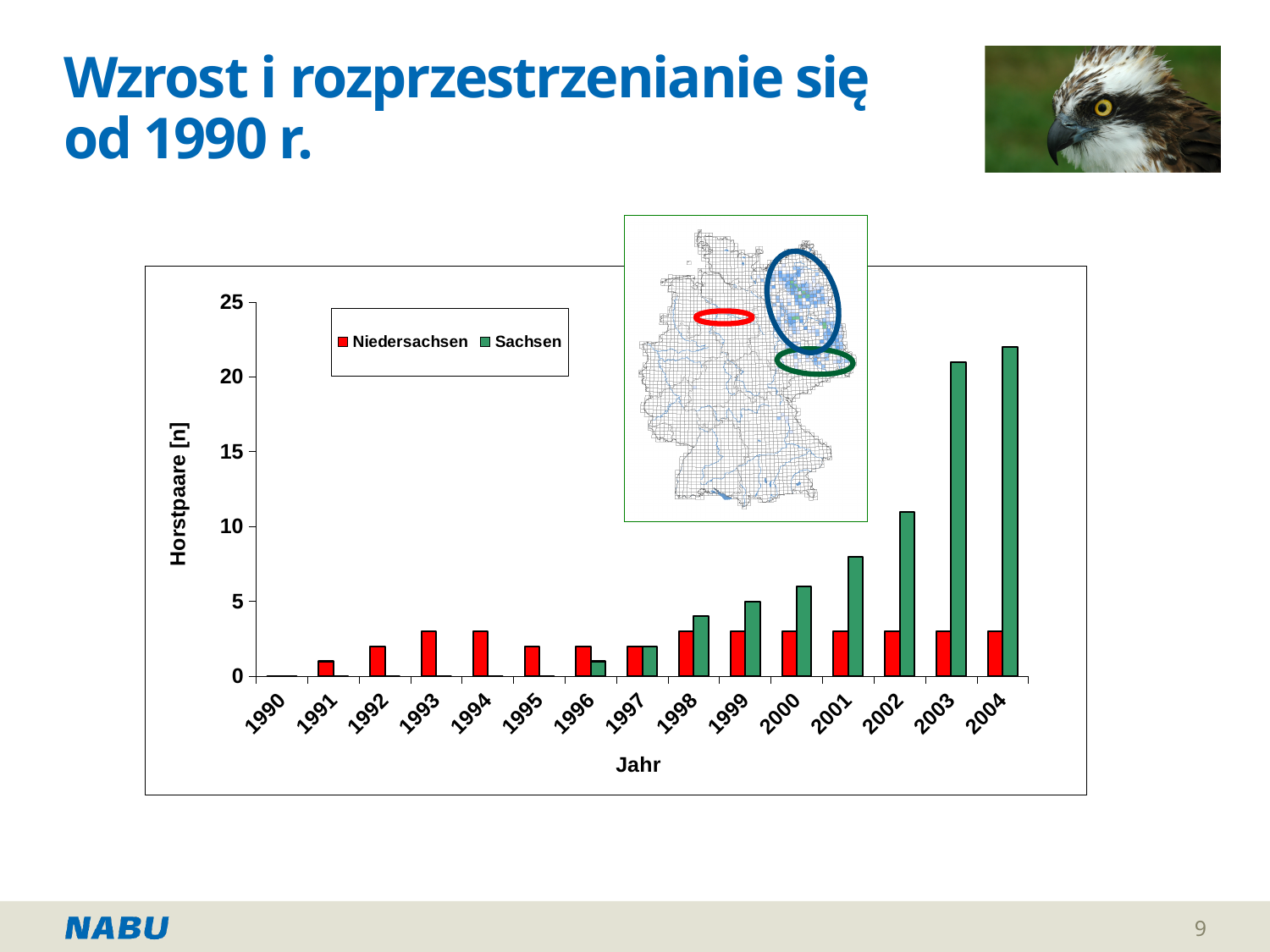
Is the Sachsen value for 2002 greater or less than 10? greater Is the Sachsen value for 2001 greater or less than 10? less Do the Sachsen values rise or fall from 1996 to 2004? rise Is the Niedersachsen value for 2004 greater or less than 5? less What kind of chart is shown on the slide? bar chart In 1993, which series has the larger value, Niedersachsen or Sachsen? Niedersachsen What is the label of the y axis of the chart? Horstpaare [n] In 2004, which series has the larger value, Niedersachsen or Sachsen? Sachsen Which two series are listed in the chart's legend? Niedersachsen and Sachsen How many series does the chart's legend list? 2 How many years are shown along the x axis of the chart? 15